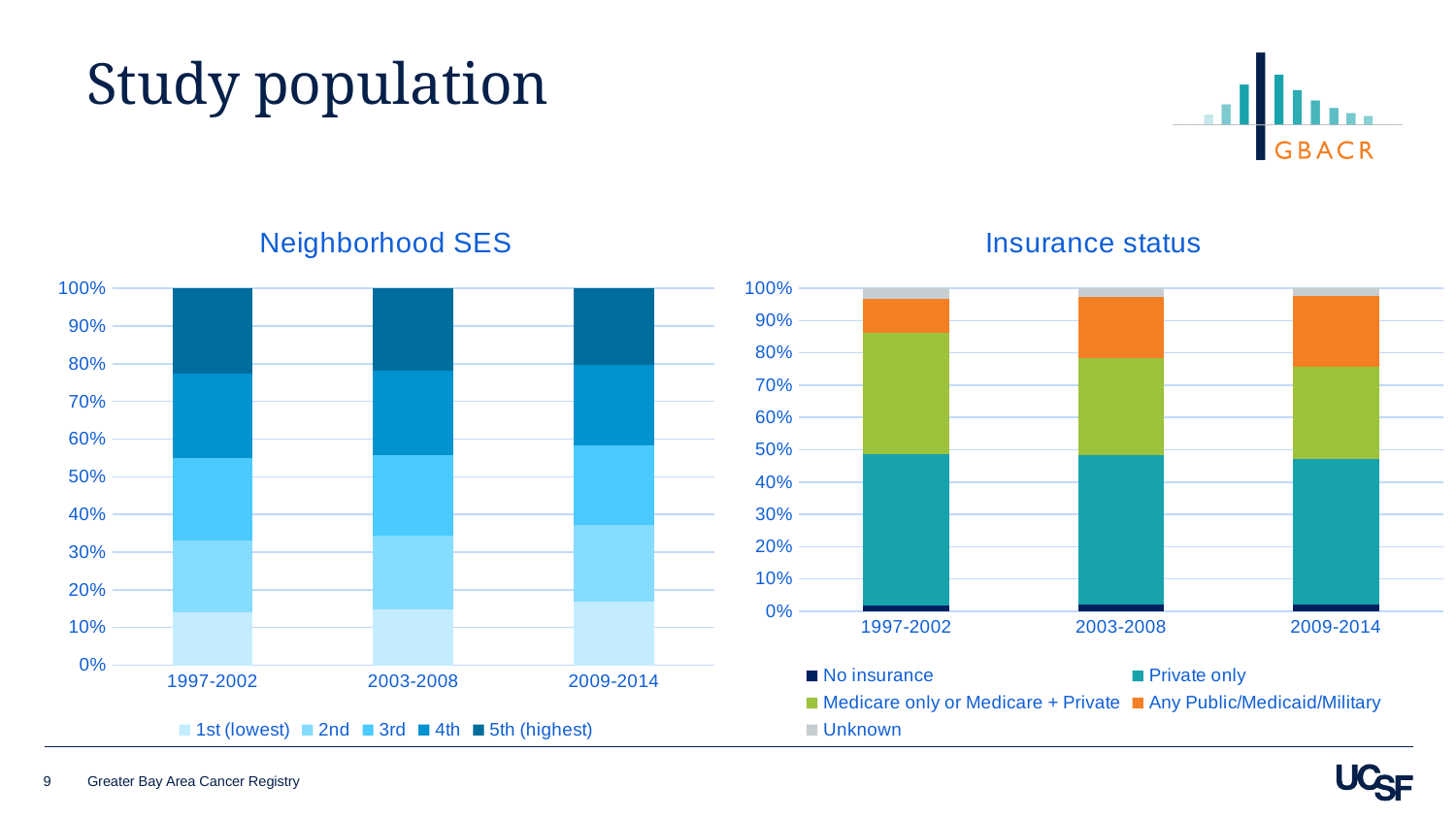
What kind of chart is the Neighborhood SES chart? Stacked bar chart In the Insurance status chart, is the No insurance segment for 2003-2008 greater or less than 10%? less In the Insurance status chart, does the Medicare only or Medicare + Private segment rise or fall from 1997-2002 to 2009-2014? fall How many series does the legend of the Neighborhood SES chart list? 5 In the Neighborhood SES chart, what is the total height of each stacked bar? 100% What is the title of the chart on the right side of the slide? Insurance status In the Insurance status chart, is the top of the Medicare only or Medicare + Private segment for 1997-2002 greater or less than 80%? greater How many series does the legend of the Insurance status chart list? 5 In the Neighborhood SES chart, is the top of the 1st (lowest) segment for 1997-2002 greater or less than 20%? less In the Insurance status chart, is the Any Public/Medicaid/Military segment larger in 1997-2002 or in 2009-2014? 2009-2014 In the Neighborhood SES chart, which legend entry is labelled as the highest SES quintile? 5th (highest) How many time periods are shown on the x axis of the Insurance status chart? 3